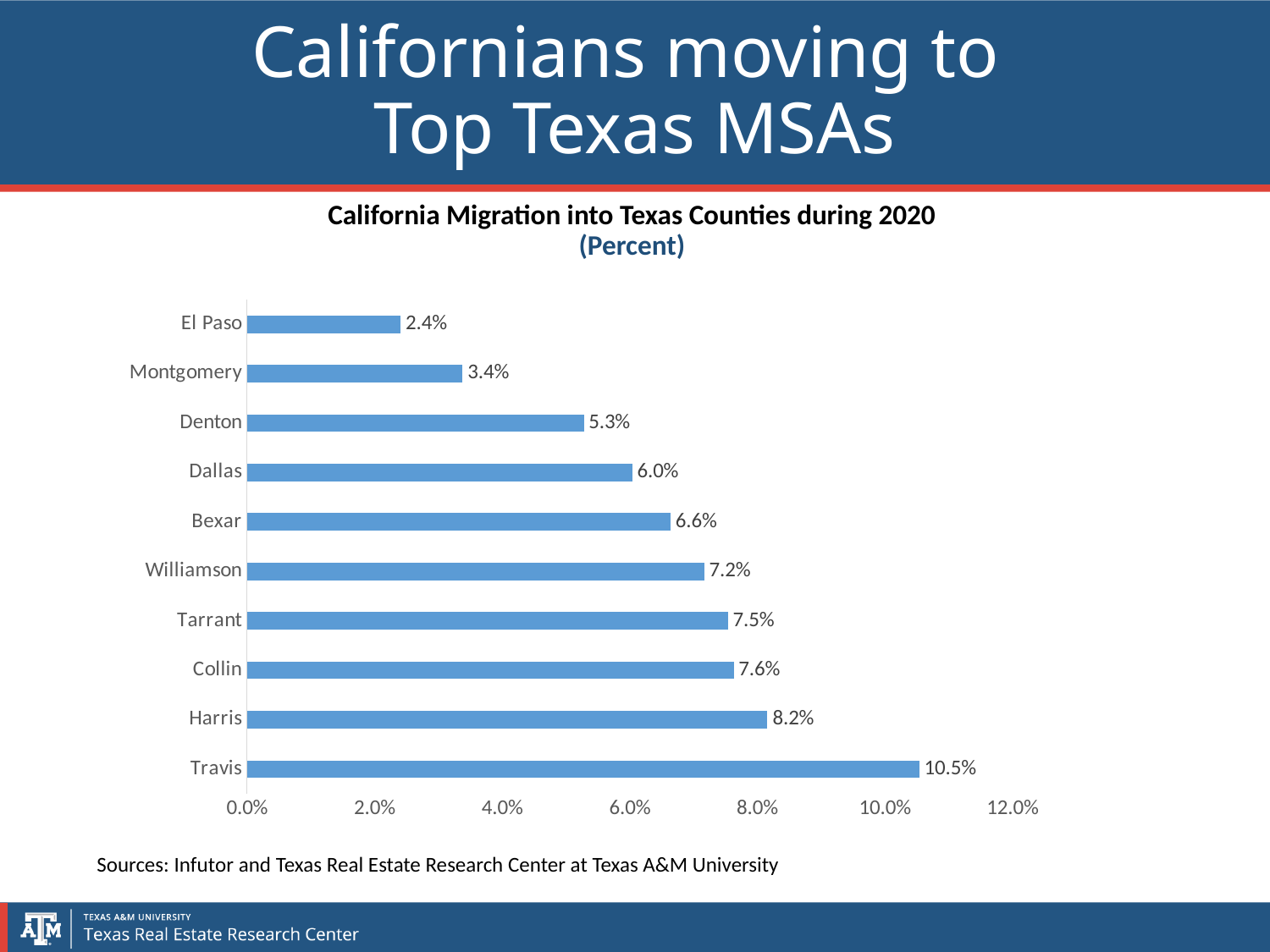
What is the value for Travis? 10.5% Which is larger, the value for Bexar or the value for Dallas? Bexar What is the value for Montgomery? 3.4% Which county has the highest value? Travis How many counties are shown in the chart? 10 Which county has the lowest value? El Paso What is the title of the chart? California Migration into Texas Counties during 2020 (Percent) What kind of chart is shown on the slide? Bar chart Is the value for Harris greater or less than 8.0%? greater What is the difference between the values for Travis and Harris? 2.3% What is the difference between the values for Dallas and El Paso? 3.6% What is the value for Denton? 5.3%